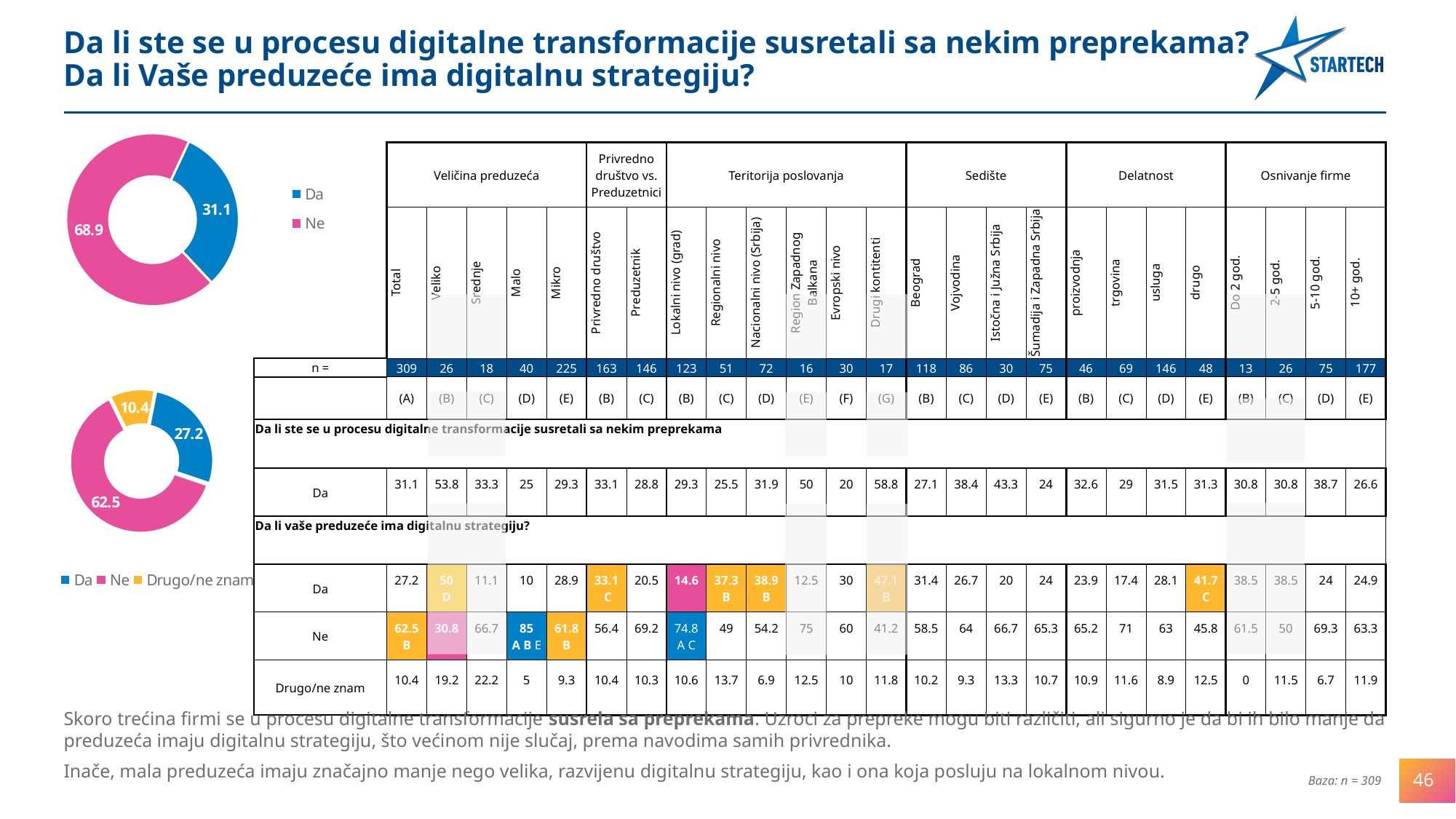
In the bottom donut chart, which category has the smallest slice? Drugo/ne znam In the bottom donut chart, what is the value for "Drugo/ne znam"? 10.4 What kind of chart is the top chart on the left of the slide? Pie (donut) chart How many slices does the bottom donut chart have? 3 In the bottom donut chart, which is larger, "Da" or "Ne"? Ne In the bottom donut chart, what is the value for "Ne"? 62.5 In the bottom donut chart, which category has the largest slice? Ne In the top donut chart, what is the value for "Da"? 31.1 In the top donut chart, what is the difference between the "Ne" and "Da" values? 37.8 How many entries does the legend of the top donut chart list? 2 In the top donut chart, what is the value for "Ne"? 68.9 In the bottom donut chart, what is the difference between the "Da" and "Drugo/ne znam" values? 16.8